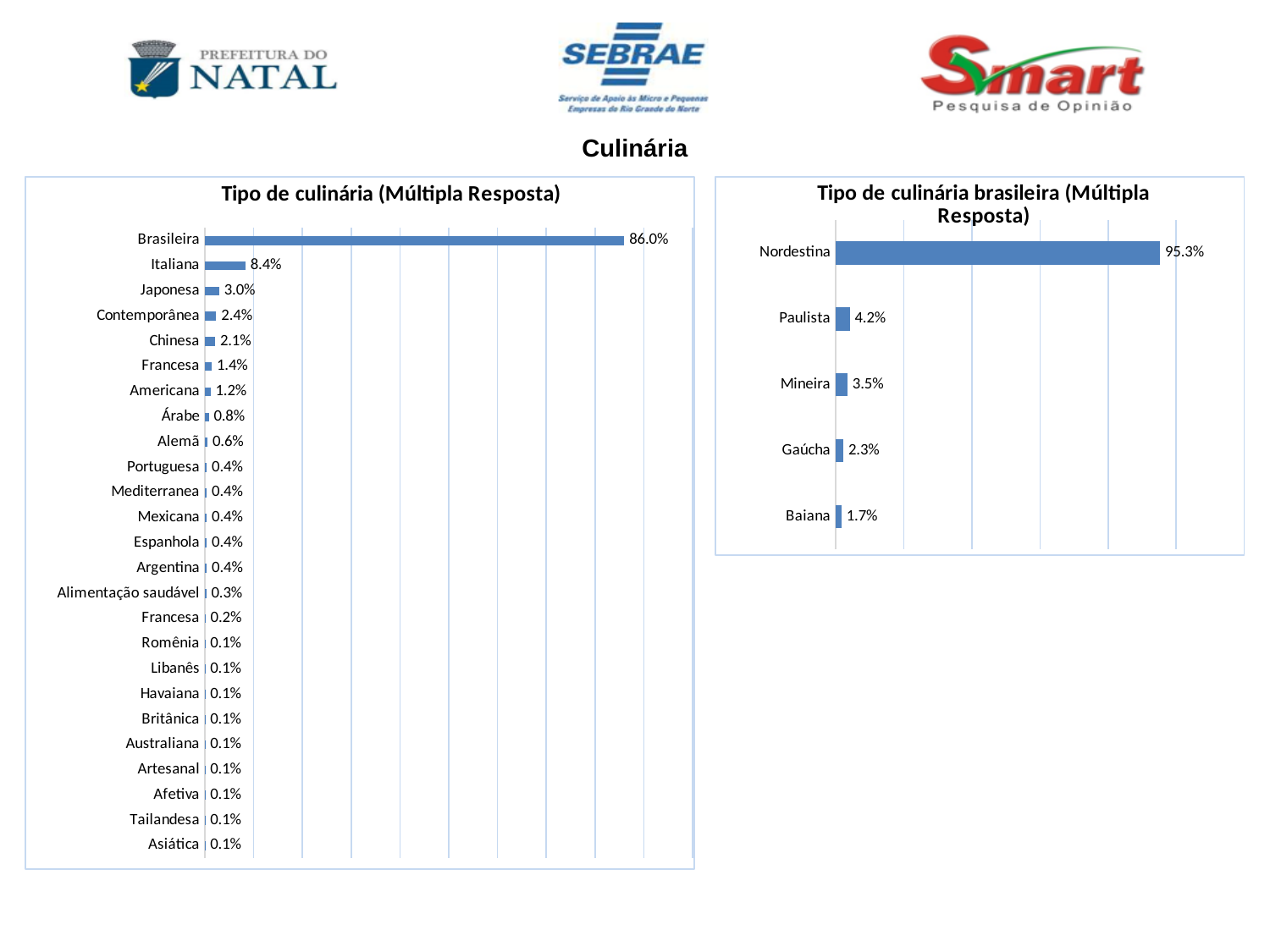
In the chart 'Tipo de culinária (Múltipla Resposta)', which is larger, Chinesa or Americana? Chinesa In the chart 'Tipo de culinária brasileira (Múltipla Resposta)', what is the value for Mineira? 3.5% In the chart 'Tipo de culinária (Múltipla Resposta)', which category has the highest value? Brasileira In the chart 'Tipo de culinária (Múltipla Resposta)', what is the value for Japonesa? 3.0% In the chart 'Tipo de culinária brasileira (Múltipla Resposta)', what is the difference between Paulista and Gaúcha? 1.9% In the chart 'Tipo de culinária brasileira (Múltipla Resposta)', which category has the lowest value? Baiana In the chart 'Tipo de culinária (Múltipla Resposta)', what is the difference between Brasileira and Italiana? 77.6% In the chart 'Tipo de culinária (Múltipla Resposta)', what is the value for Brasileira? 86.0% In the chart 'Tipo de culinária (Múltipla Resposta)', what is the value for Italiana? 8.4% What type of chart is 'Tipo de culinária brasileira (Múltipla Resposta)'? Bar chart How many categories are shown in the chart 'Tipo de culinária (Múltipla Resposta)'? 25 In the chart 'Tipo de culinária brasileira (Múltipla Resposta)', what is the value for Nordestina? 95.3%